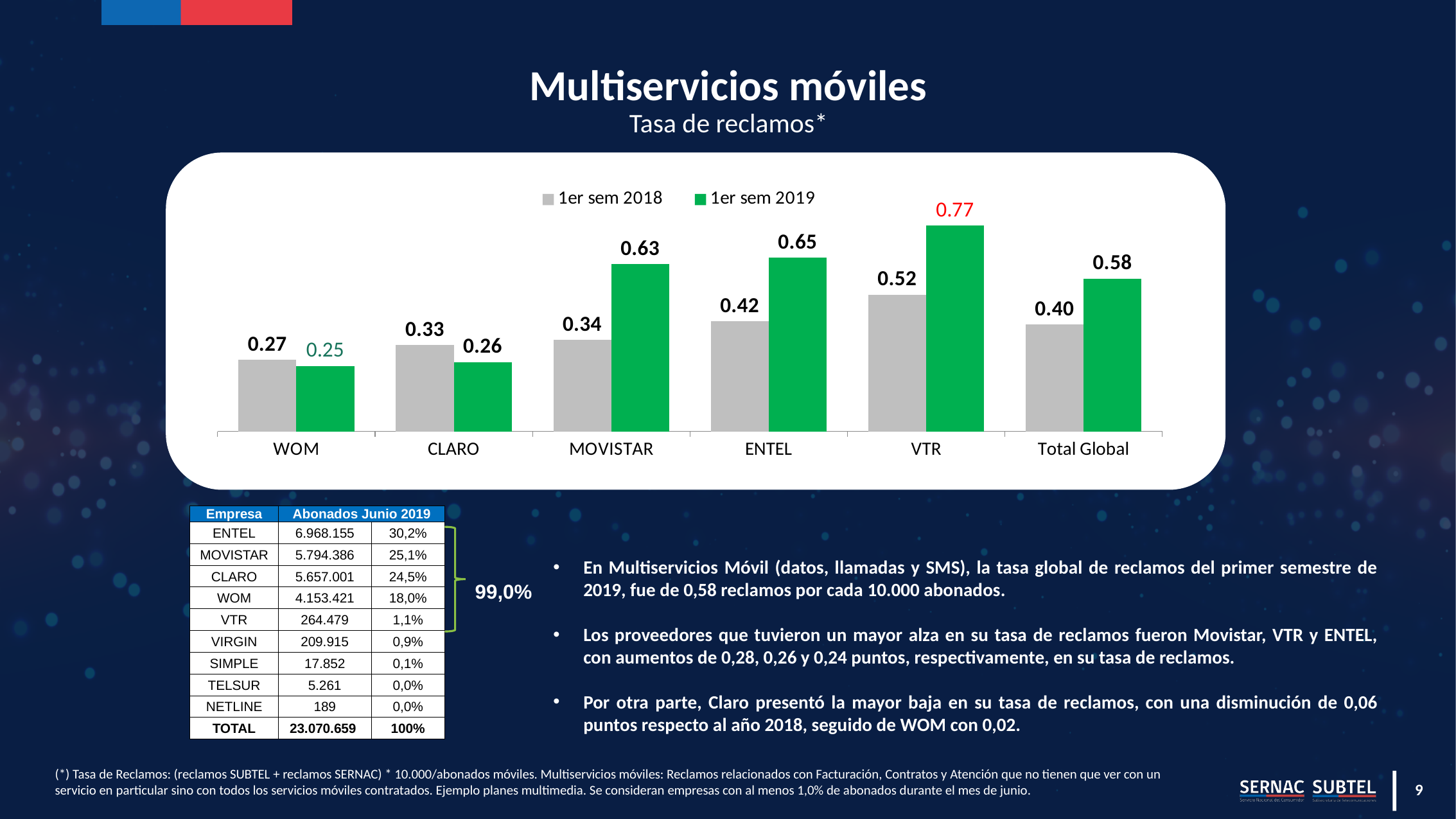
What is the value for VTR in the 1er sem 2019 series? 0.77 Which category has the lowest value in the 1er sem 2019 series? WOM What kind of chart is shown on the slide? Bar chart What is the Total Global value for 1er sem 2019? 0.58 What are the two series named in the chart legend? 1er sem 2018 and 1er sem 2019 Which category has the highest value in the 1er sem 2019 series? VTR What is the value for MOVISTAR in the 1er sem 2018 series? 0.34 What colour are the bars for the 1er sem 2019 series? Green How many categories are shown on the x axis of the chart? 6 Which is larger for CLARO: the 1er sem 2018 value or the 1er sem 2019 value? 1er sem 2018 How many series does the chart legend list? 2 What is the difference between the 1er sem 2019 and 1er sem 2018 values for ENTEL? 0.23